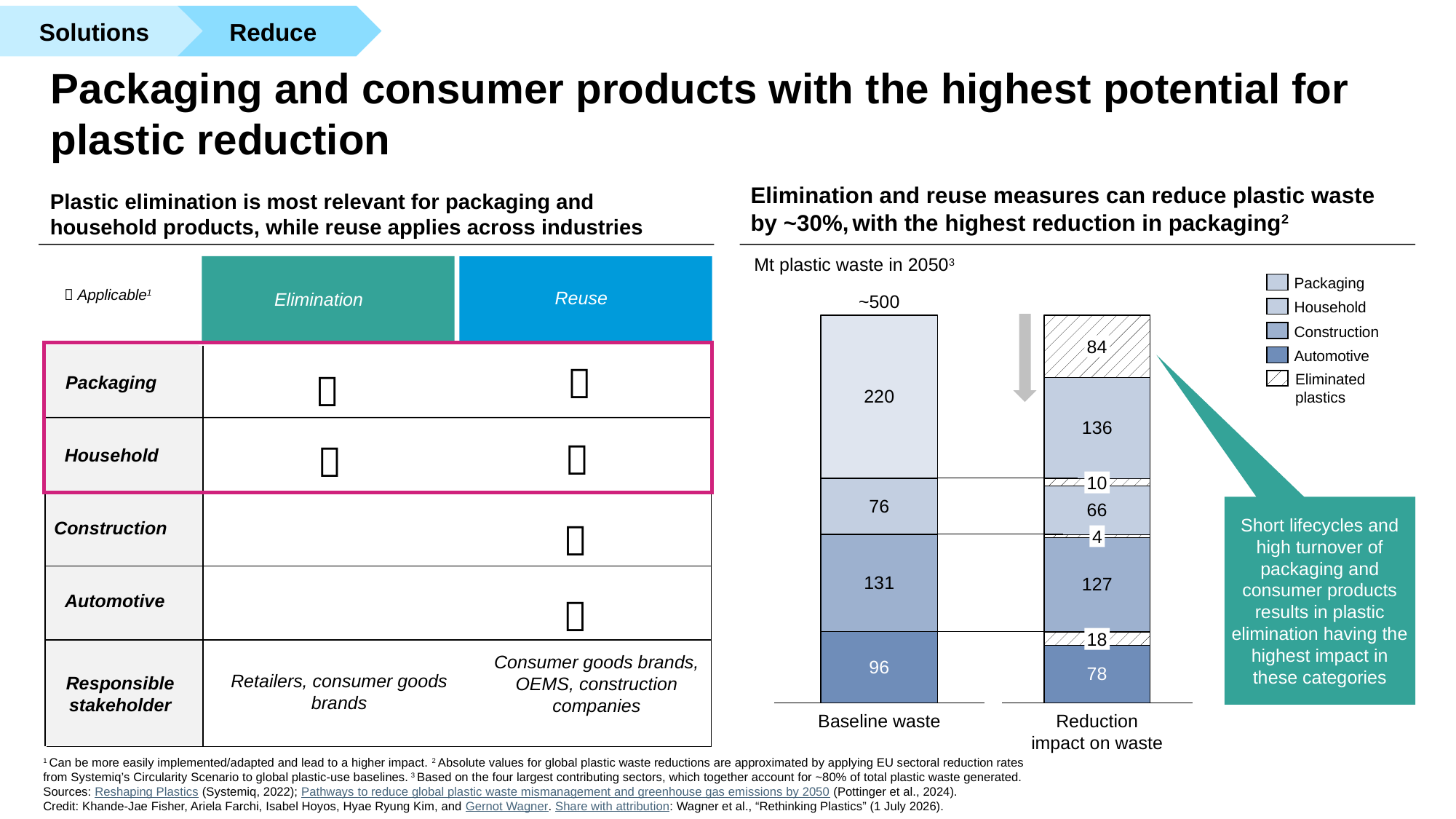
Which sector has the largest segment in the Baseline waste bar? Packaging What is the total of the Eliminated plastics segments (84, 10, 4, 18) in the Reduction impact on waste bar? 116 What is the Construction value in the Reduction impact on waste bar? 127 What is the Packaging value in the Baseline waste bar? 220 How many bars does the chart on the right show? 2 What is the Automotive value in the Baseline waste bar? 96 What is the Household value in the Reduction impact on waste bar? 66 By how much does the Packaging value fall from the Baseline waste bar (220) to the Reduction impact on waste bar (136)? 84 What type of chart is shown on the right side of the slide? Stacked bar chart In the Baseline waste bar, which is larger: Construction or Automotive? Construction How many entries does the legend of the chart list? 5 Which sector has the smallest segment in the Baseline waste bar? Household